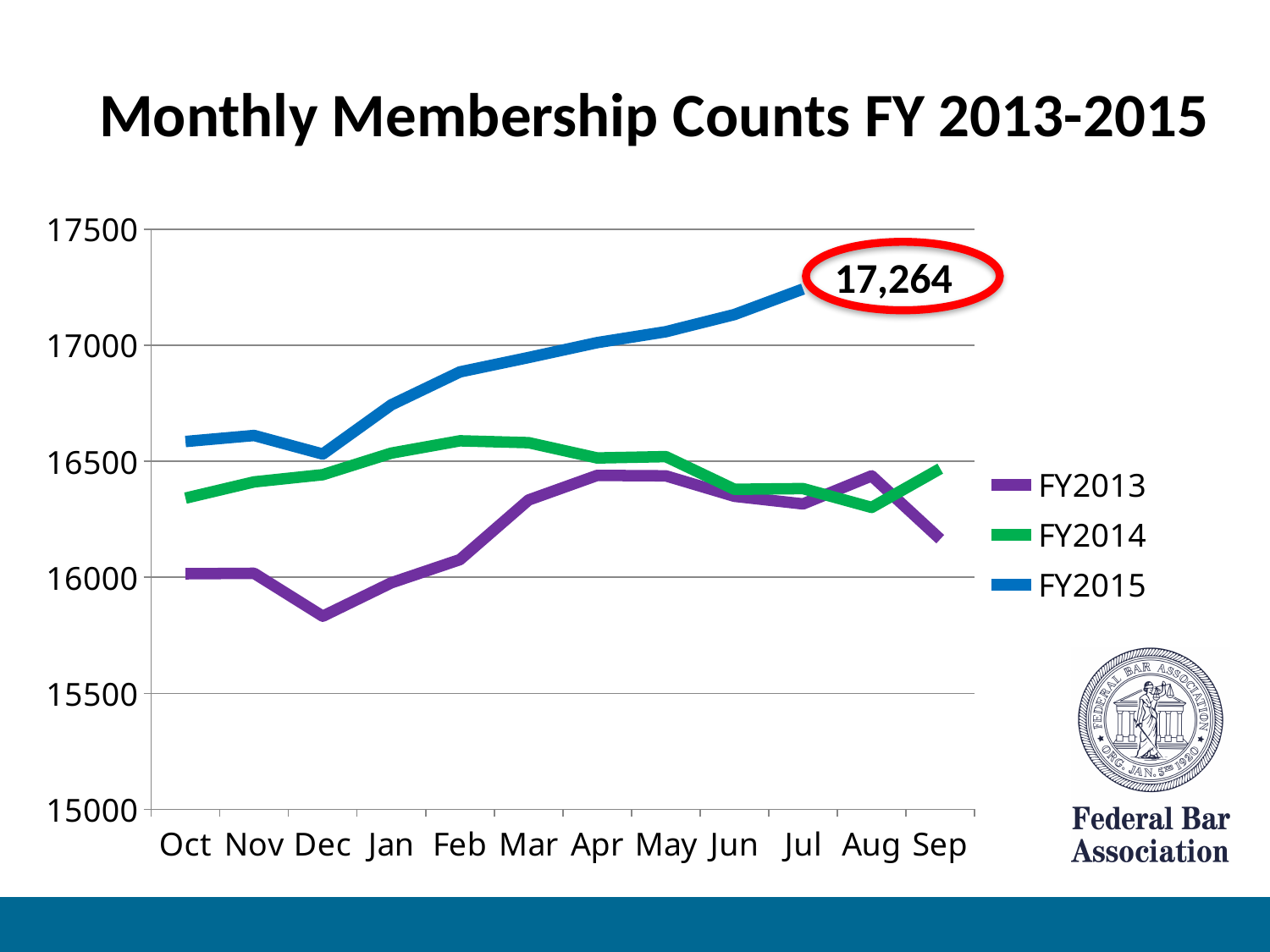
Which fiscal year has the highest membership count in Jul? FY2015 Is the FY2015 value for Jun greater or less than 17000? greater Is the FY2013 value for Dec greater or less than 16000? less How many series does the legend list? 3 Does the FY2015 line generally rise or fall from Oct to Jul? rise What is the title of the chart? Monthly Membership Counts FY 2013-2015 In Oct, which series has the higher value, FY2013 or FY2014? FY2014 How many months are shown along the x axis? 12 What is the labelled membership count for FY2015 in Jul? 17,264 Is the FY2014 value for Oct greater or less than 16500? less What kind of chart is shown on the slide? line chart In which month does the FY2013 line reach its lowest point? Dec